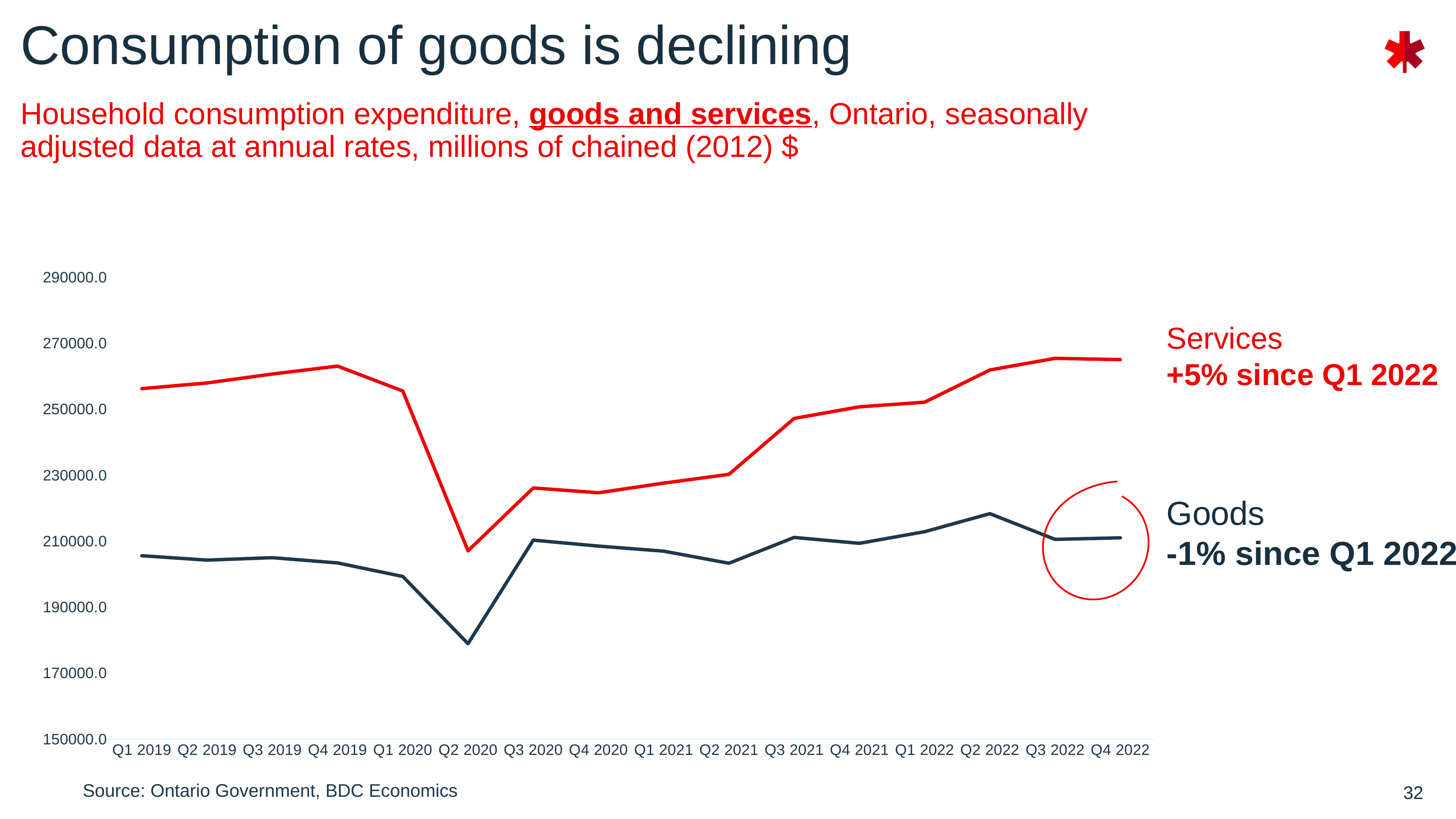
Does the Services series rise or fall from Q2 2020 to Q4 2022? rise How many quarters are shown along the x axis? 16 Is the value for Goods in Q2 2022 greater or less than 210000.0? greater According to the annotation, by what percentage has Services changed since Q1 2022? +5% Is the value for Services in Q4 2022 greater or less than 250000.0? greater In which quarter does the Goods series reach its lowest value? Q2 2020 Which series has the higher value in Q4 2022, Services or Goods? Services In which quarter does the Services series reach its lowest value? Q2 2020 Is the value for Goods in Q2 2020 greater or less than 190000.0? less In which quarter does the Goods series reach its highest value? Q2 2022 What type of chart is shown on the slide? line chart How many series are plotted on the chart? 2